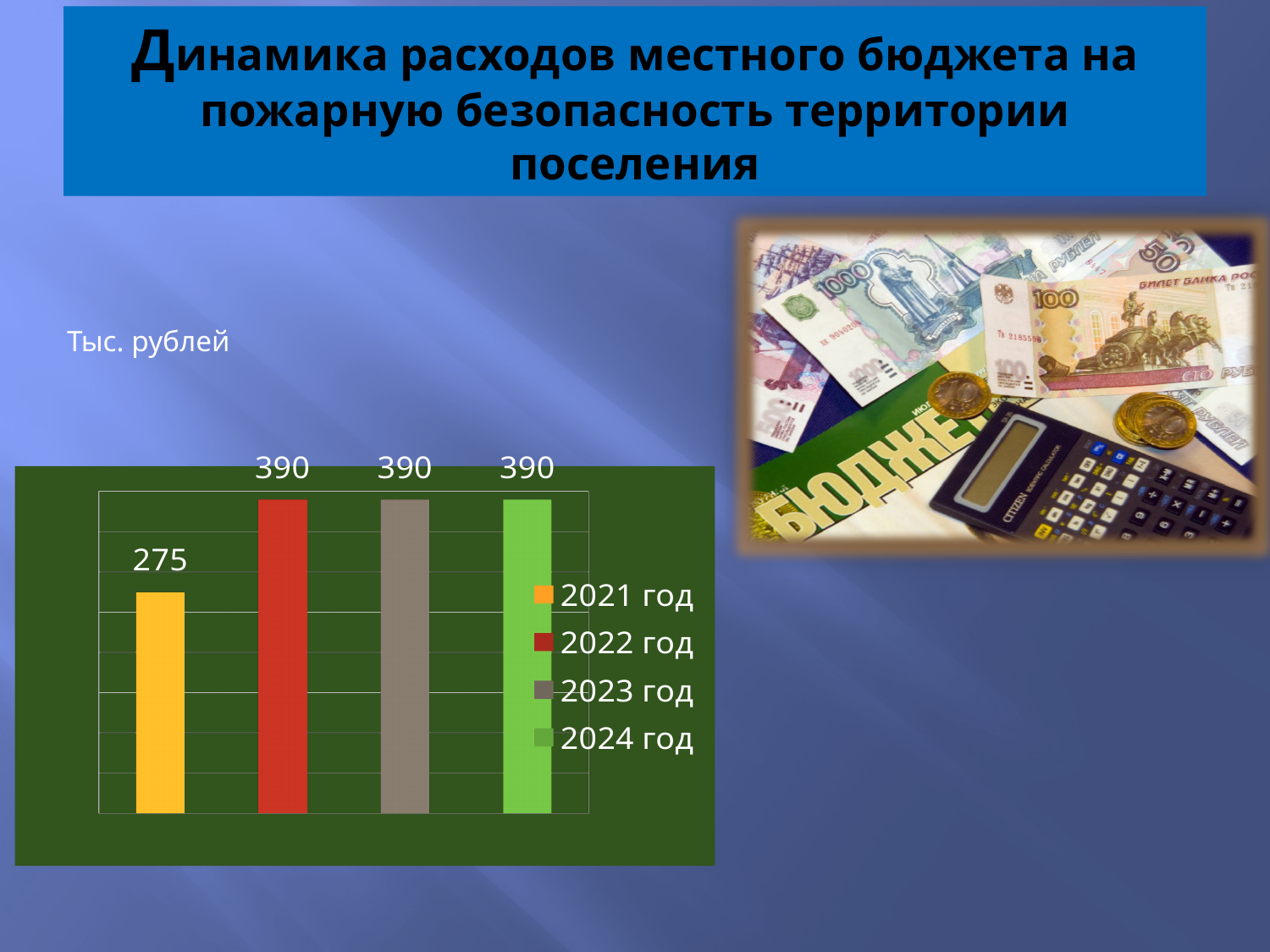
What is the value for 2021 год? 275 Which is larger, the value for 2021 год or the value for 2023 год? 2023 год How many bars are plotted in the chart? 4 What unit is stated for the chart values? Тыс. рублей What is the difference between the values for 2022 год and 2021 год? 115 What is the value for 2022 год? 390 Which year has the lowest value? 2021 год What is the value for 2024 год? 390 Do the values rise or fall from 2021 год to 2022 год? Rise How many entries does the legend list? 4 What kind of chart is shown on the slide? Bar chart What colour is the bar for 2021 год? Yellow